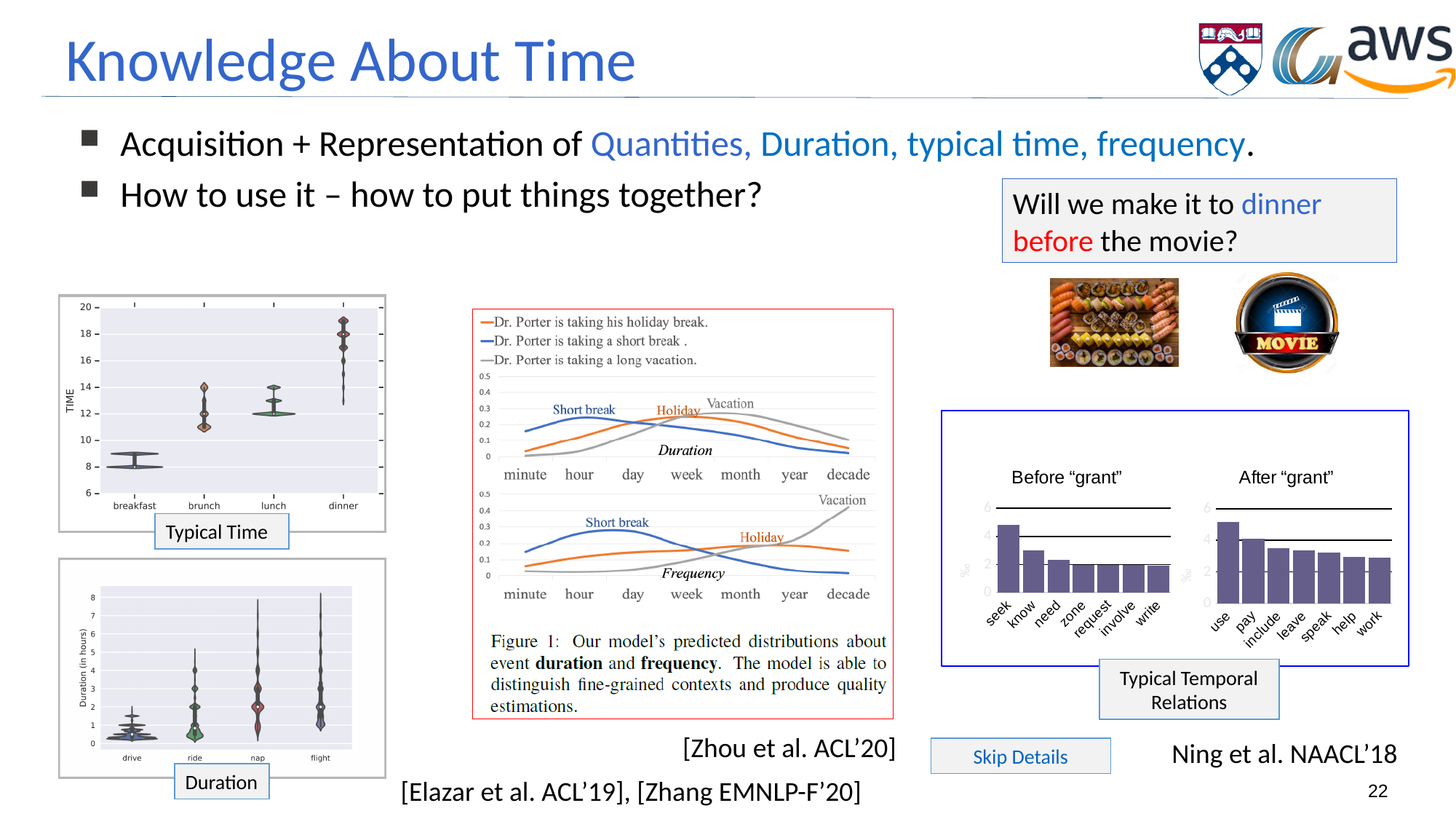
In the Typical Time chart, is the value for breakfast greater or less than 10? less How many series does the legend list in the Zhou et al. Duration/Frequency figure? 3 In the After "grant" chart, is the value for use greater or less than 4? greater In the Before "grant" chart, which category has the highest value? seek What is the y-axis label of the Duration chart? Duration (in hours) How many points are on the x axis of the Duration panel in the Zhou et al. figure? 7 In the Frequency panel of the Zhou et al. figure, which series is highest at decade? Vacation In the Typical Time chart, which category has the lowest time values? breakfast In the Duration chart, which category has the lowest duration values? drive How many categories are shown on the x axis of the Typical Time chart? 4 What kind of chart is the Before "grant" chart? bar chart In the Typical Time chart, which category has the highest time values? dinner